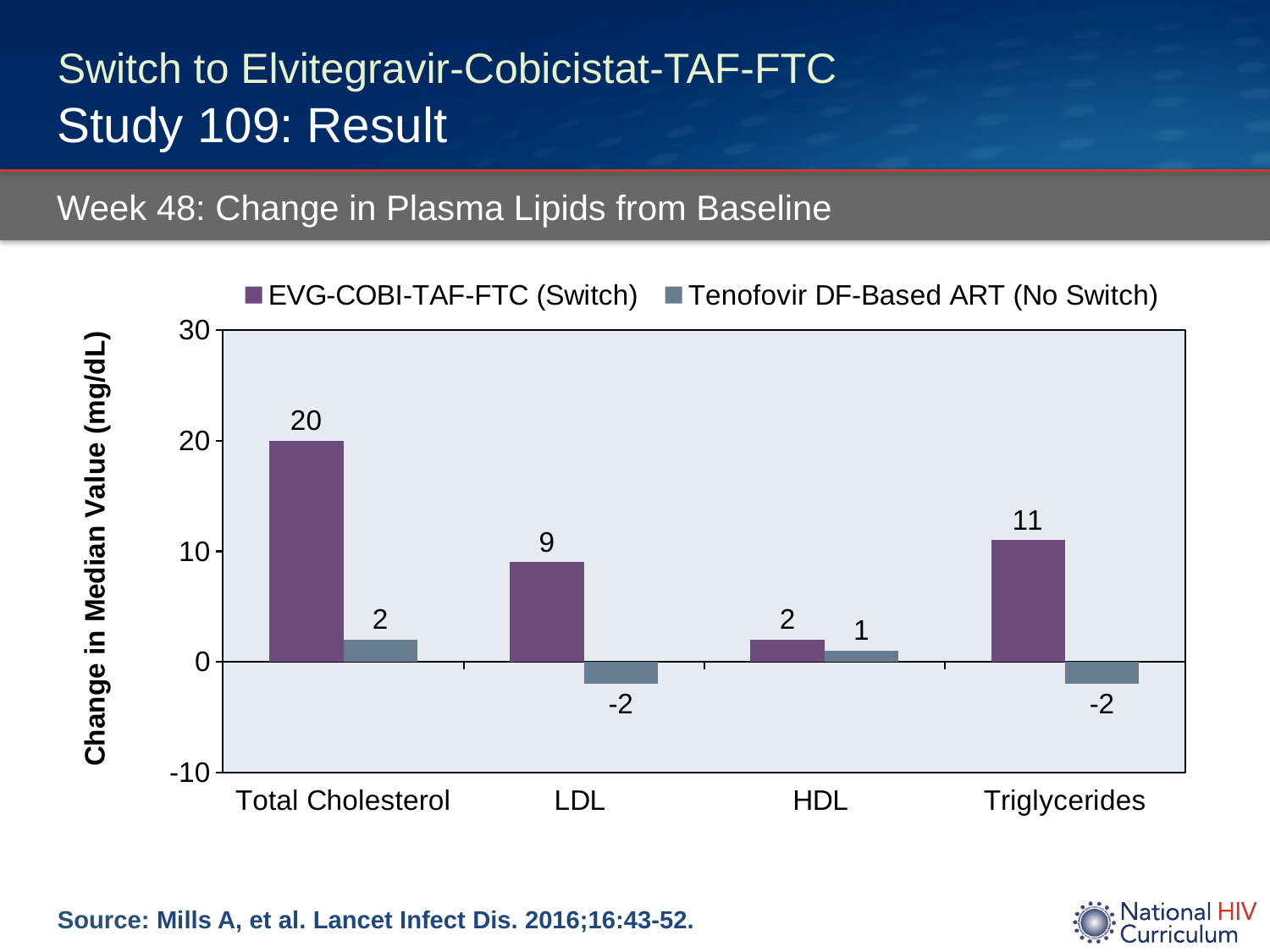
What is the difference between the EVG-COBI-TAF-FTC (Switch) and Tenofovir DF-Based ART (No Switch) values for Total Cholesterol? 18 Which group has the larger change in LDL, EVG-COBI-TAF-FTC (Switch) or Tenofovir DF-Based ART (No Switch)? EVG-COBI-TAF-FTC (Switch) How many lipid categories are shown on the x axis? 4 What is the difference between the EVG-COBI-TAF-FTC (Switch) and Tenofovir DF-Based ART (No Switch) values for Triglycerides? 13 What is the change in median value for LDL in the Tenofovir DF-Based ART (No Switch) group? -2 Which lipid category has the highest value for the EVG-COBI-TAF-FTC (Switch) group? Total Cholesterol Which lipid category has the lowest value for the EVG-COBI-TAF-FTC (Switch) group? HDL What is the change in median value for HDL in the EVG-COBI-TAF-FTC (Switch) group? 2 What is the change in median value for Total Cholesterol in the EVG-COBI-TAF-FTC (Switch) group? 20 What is the change in median value for Triglycerides in the EVG-COBI-TAF-FTC (Switch) group? 11 What kind of chart is shown on the slide? Bar chart How many series does the legend list? 2